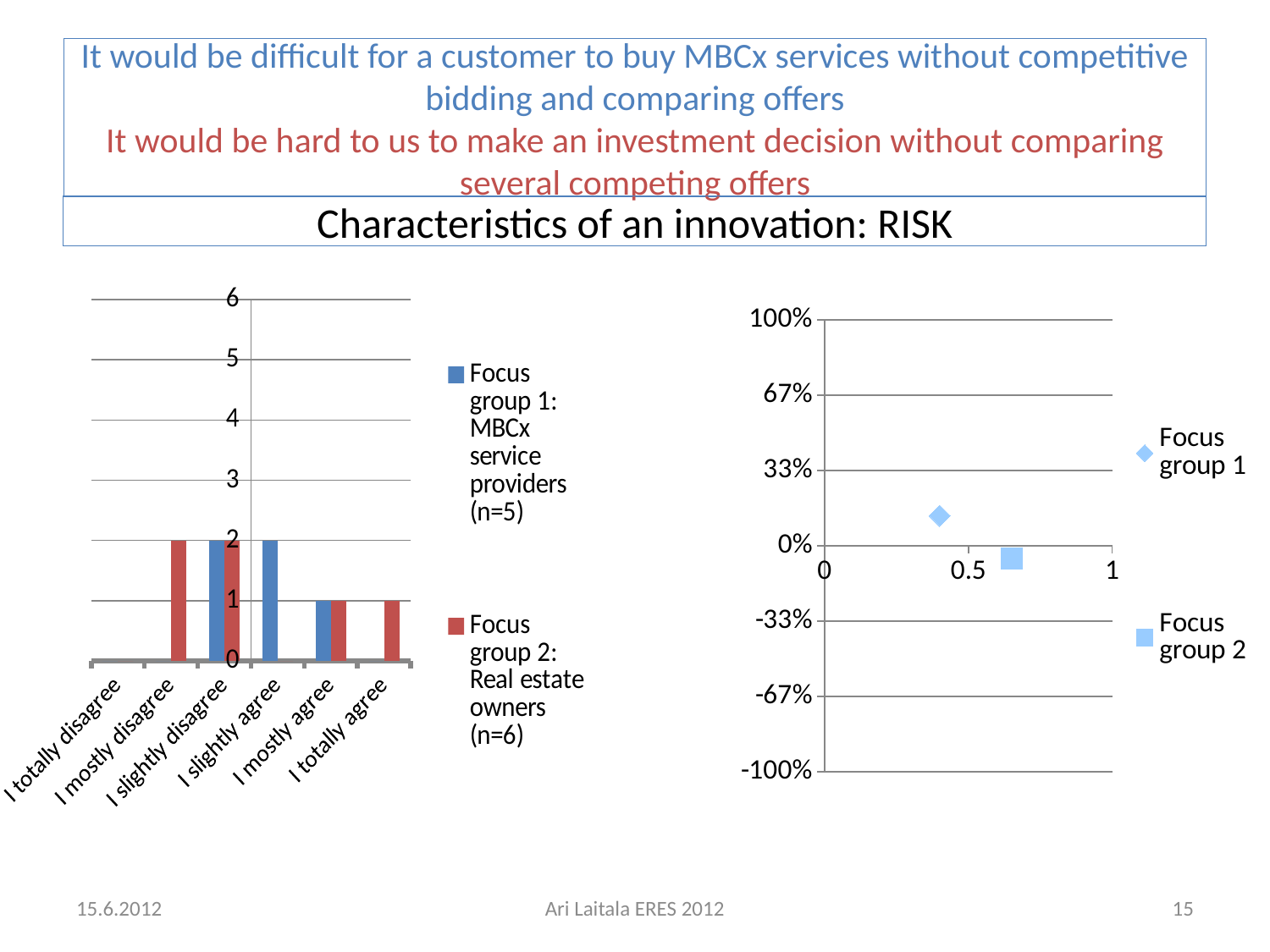
In the bar chart on the left, what is the value for Focus group 2: Real estate owners (n=6) in the 'I mostly disagree' category? 2 In the bar chart on the left, what is the value for Focus group 2: Real estate owners (n=6) in the 'I totally agree' category? 1 In the bar chart on the left, what is the value for Focus group 1: MBCx service providers (n=5) in the 'I mostly agree' category? 1 What kind of chart is the chart on the left? Bar chart In the scatter chart on the right, is the horizontal value for Focus group 1 greater or less than 0.5? less In the bar chart on the left, what is the difference between the Focus group 1 and Focus group 2 values in the 'I slightly agree' category? 2 In the bar chart on the left, which series has the larger value in the 'I mostly disagree' category? Focus group 2: Real estate owners (n=6) In the scatter chart on the right, is the vertical value for Focus group 2 greater or less than 0%? less In the scatter chart on the right, is the vertical value for Focus group 1 greater or less than 0%? greater In the bar chart on the left, how many series does the legend list? 2 In the bar chart on the left, what is the value for Focus group 1: MBCx service providers (n=5) in the 'I slightly agree' category? 2 In the bar chart on the left, how many categories are shown on the x axis? 6